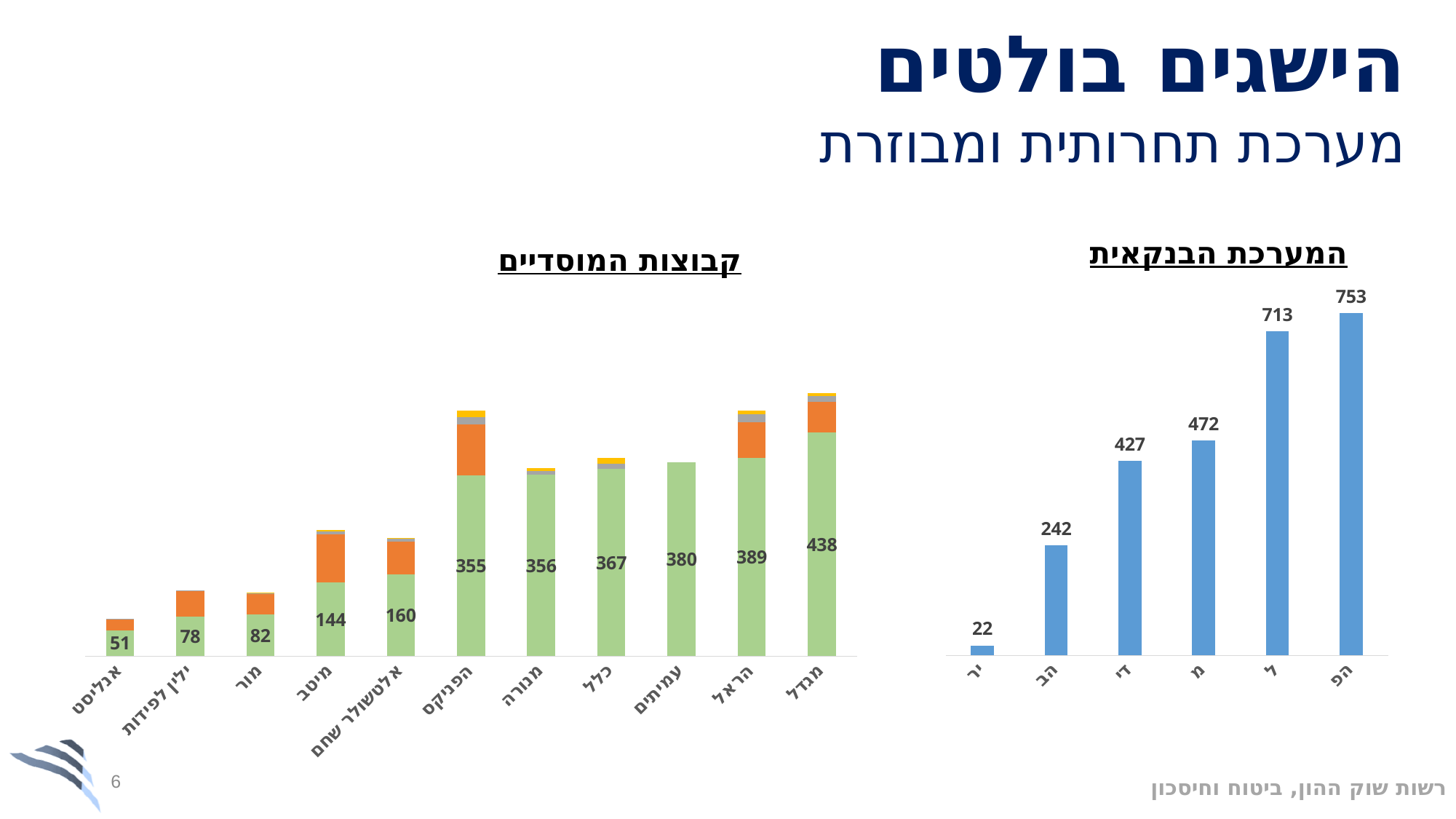
What type of chart is the chart titled קבוצות המוסדיים? stacked bar chart In the chart titled קבוצות המוסדיים, which category has the smallest labelled green segment? אנליסט In the chart titled המערכת הבנקאית, how many bars are shown? 6 In the chart titled המערכת הבנקאית, what is the difference between the values for ל and מ? 241 In the chart titled המערכת הבנקאית, what is the value for הב? 242 In the chart titled המערכת הבנקאית, do the values rise or fall from left to right? rise In the chart titled קבוצות המוסדיים, what is the labelled value of the green segment for מגדל? 438 In the chart titled קבוצות המוסדיים, how many categories are shown on the x axis? 11 In the chart titled המערכת הבנקאית, which category has the lowest value? יר In the chart titled המערכת הבנקאית, what is the value for הפ? 753 In the chart titled קבוצות המוסדיים, what is the difference between the labelled green values for הראל and הפניקס? 34 In the chart titled קבוצות המוסדיים, what is the labelled value of the green segment for אלטשולר שחם? 160